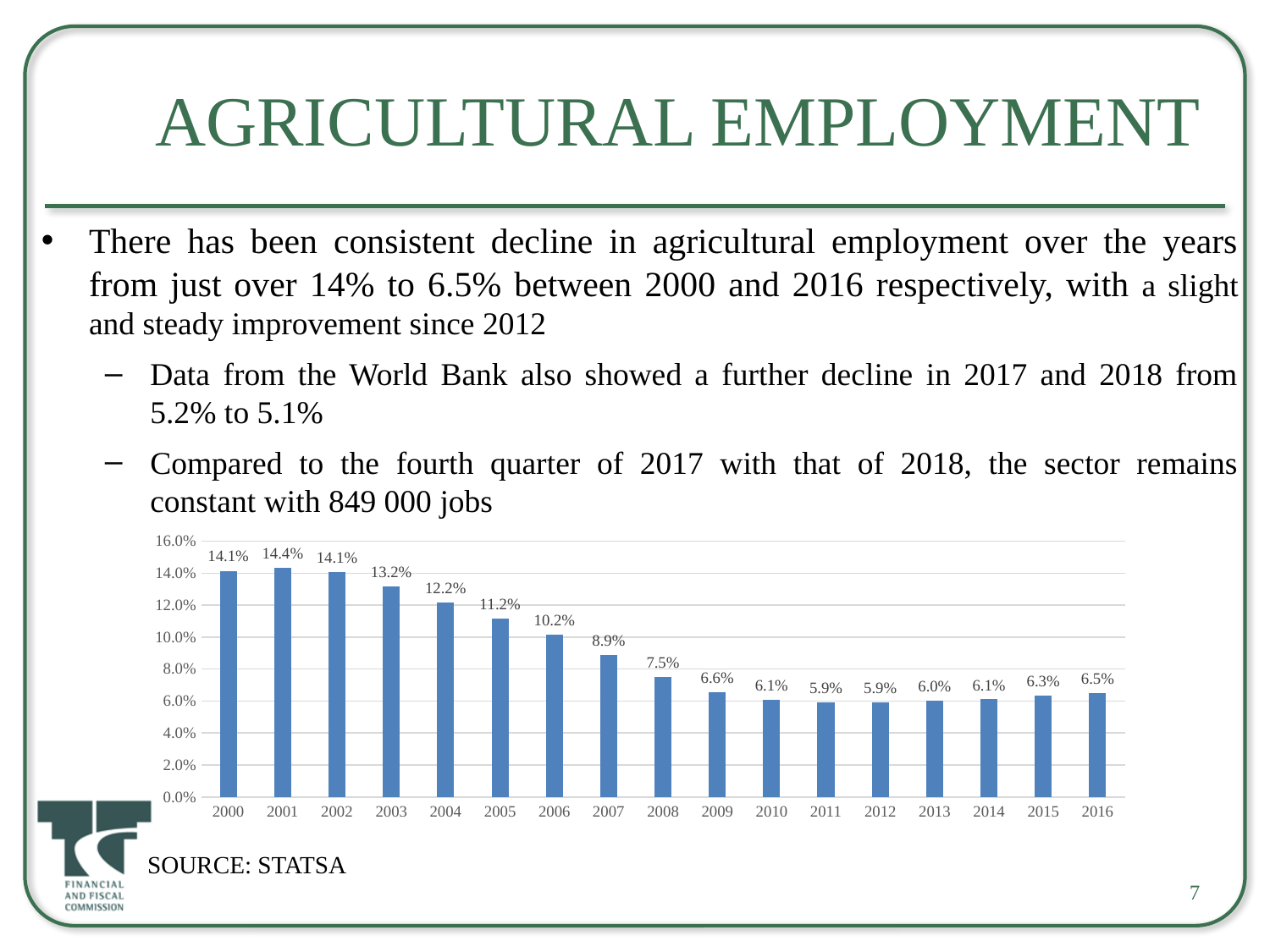
Which year has the highest value? 2001 What source is cited below the chart? STATSA What is the value for 2008? 7.5% Do the values rise or fall from 2012 to 2016? rise What is the difference between the values for 2000 and 2016? 7.6% Is the value for 2007 greater or less than 8.0%? greater What is the value for 2000? 14.1% How many years are shown on the x axis? 17 What is the value for 2016? 6.5% What kind of chart is shown on the slide? bar chart Do the values rise or fall from 2000 to 2011? fall Which is larger, the value for 2005 or the value for 2006? 2005